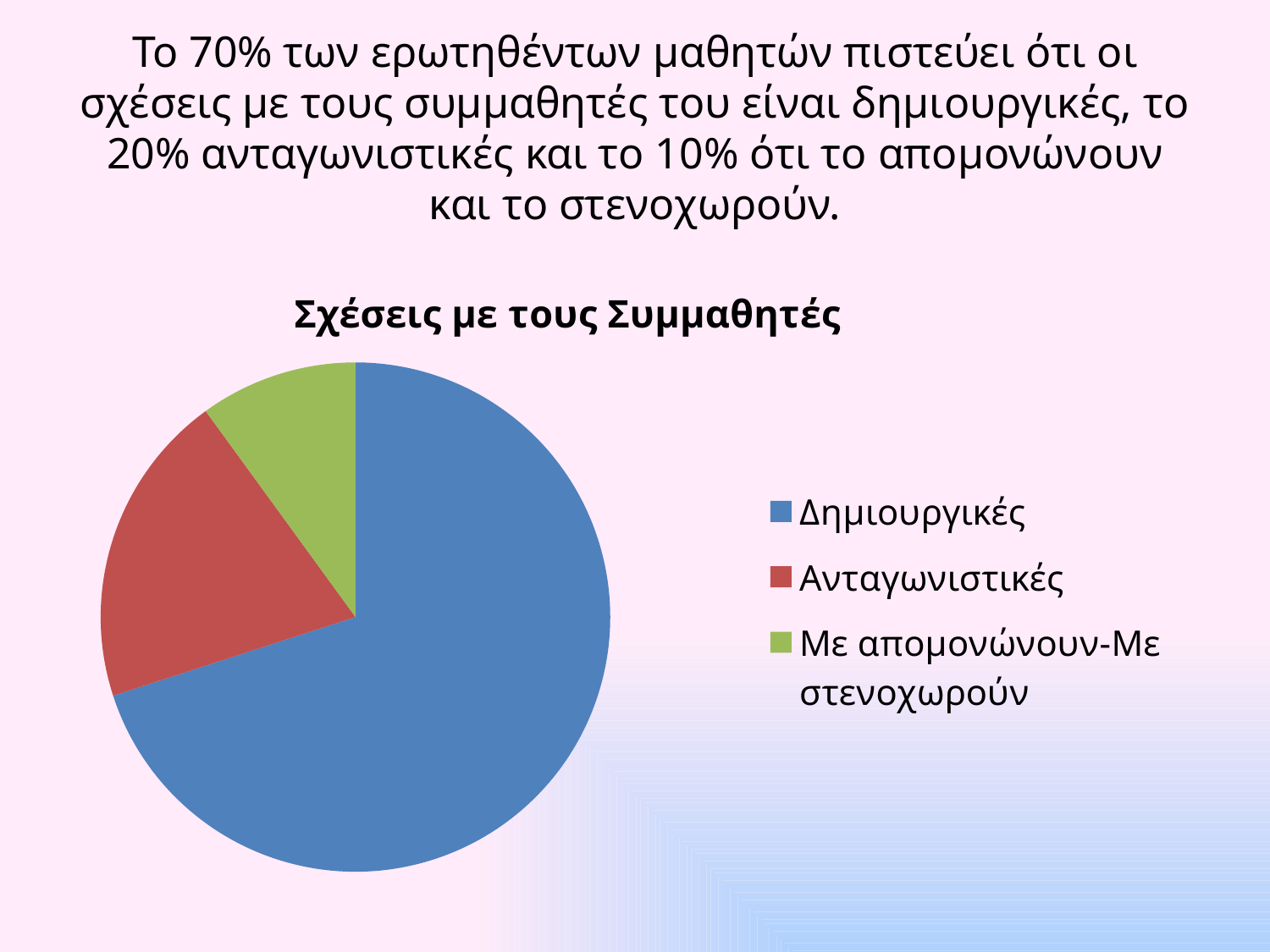
What colour is the Δημιουργικές slice in the pie chart? blue What share of the pie does the Δημιουργικές slice represent, according to the slide text? 70% What kind of chart is shown on the slide? pie chart How many slices does the pie chart have? 3 Which slice is larger, Ανταγωνιστικές or Με απομονώνουν-Με στενοχωρούν? Ανταγωνιστικές Is the Δημιουργικές slice greater or less than half of the pie? greater What share of the pie does the Ανταγωνιστικές slice represent, according to the slide text? 20% How many entries does the legend list? 3 What share of the pie does the Με απομονώνουν-Με στενοχωρούν slice represent, according to the slide text? 10% Which category has the largest slice of the pie? Δημιουργικές Which category has the smallest slice of the pie? Με απομονώνουν-Με στενοχωρούν What is the title of the chart? Σχέσεις με τους Συμμαθητές